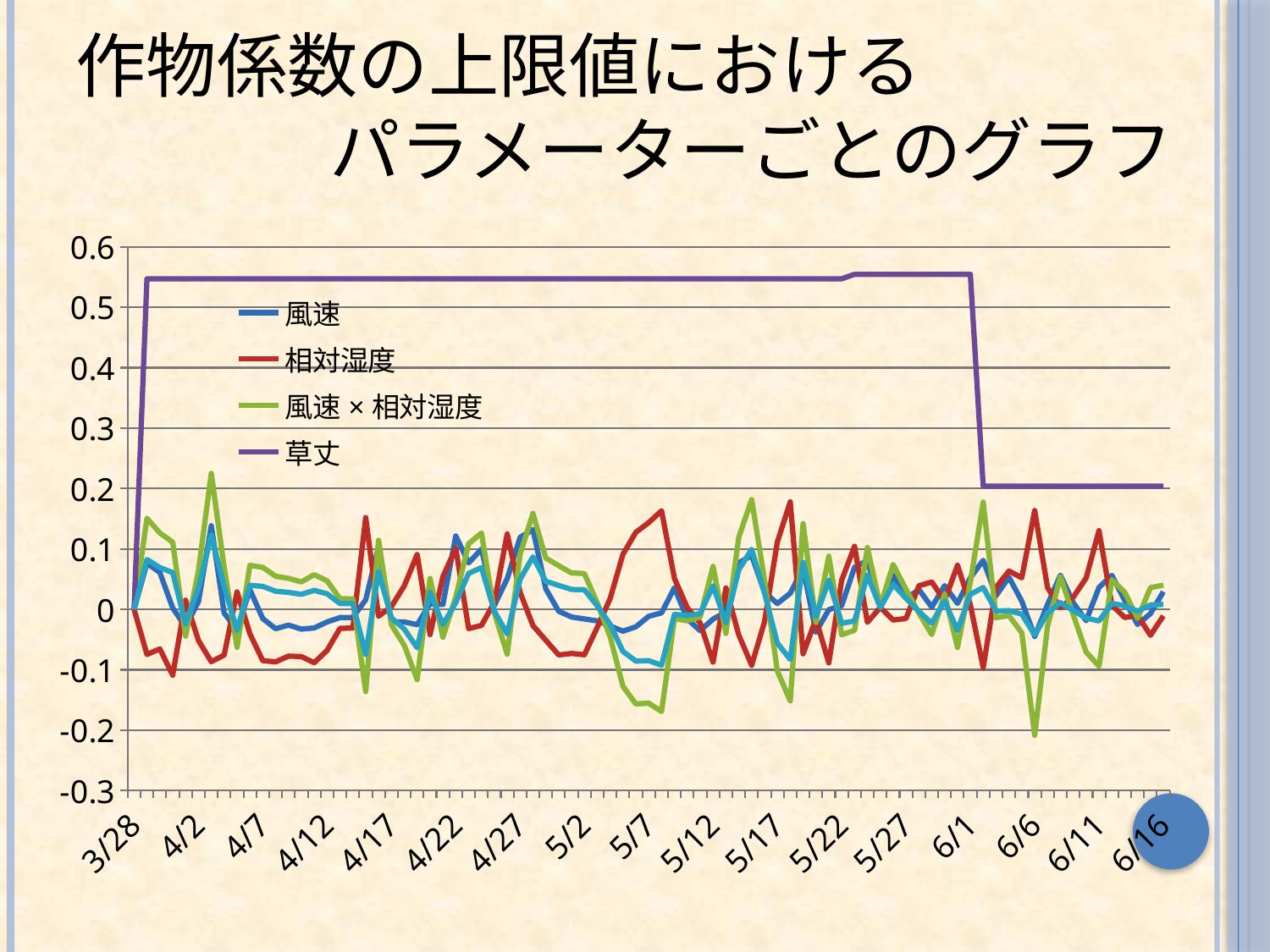
Which series reaches the lowest value on the chart? 風速 × 相対湿度 Which series is drawn in green according to the legend? 風速 × 相対湿度 What kind of chart is shown on the slide? line chart Is the value of 草丈 at 6/11 greater or less than 0.3? less Which series reaches the highest value on the chart? 草丈 How many series does the legend list? 4 Is the value of 草丈 at 4/17 greater or less than 0.5? greater Does the 草丈 series rise or fall between 6/1 and 6/6? fall At 5/2, which series has the larger value, 草丈 or 風速? 草丈 Is the value of 草丈 at 3/28 greater or less than 0.1? less Which series is drawn in purple according to the legend? 草丈